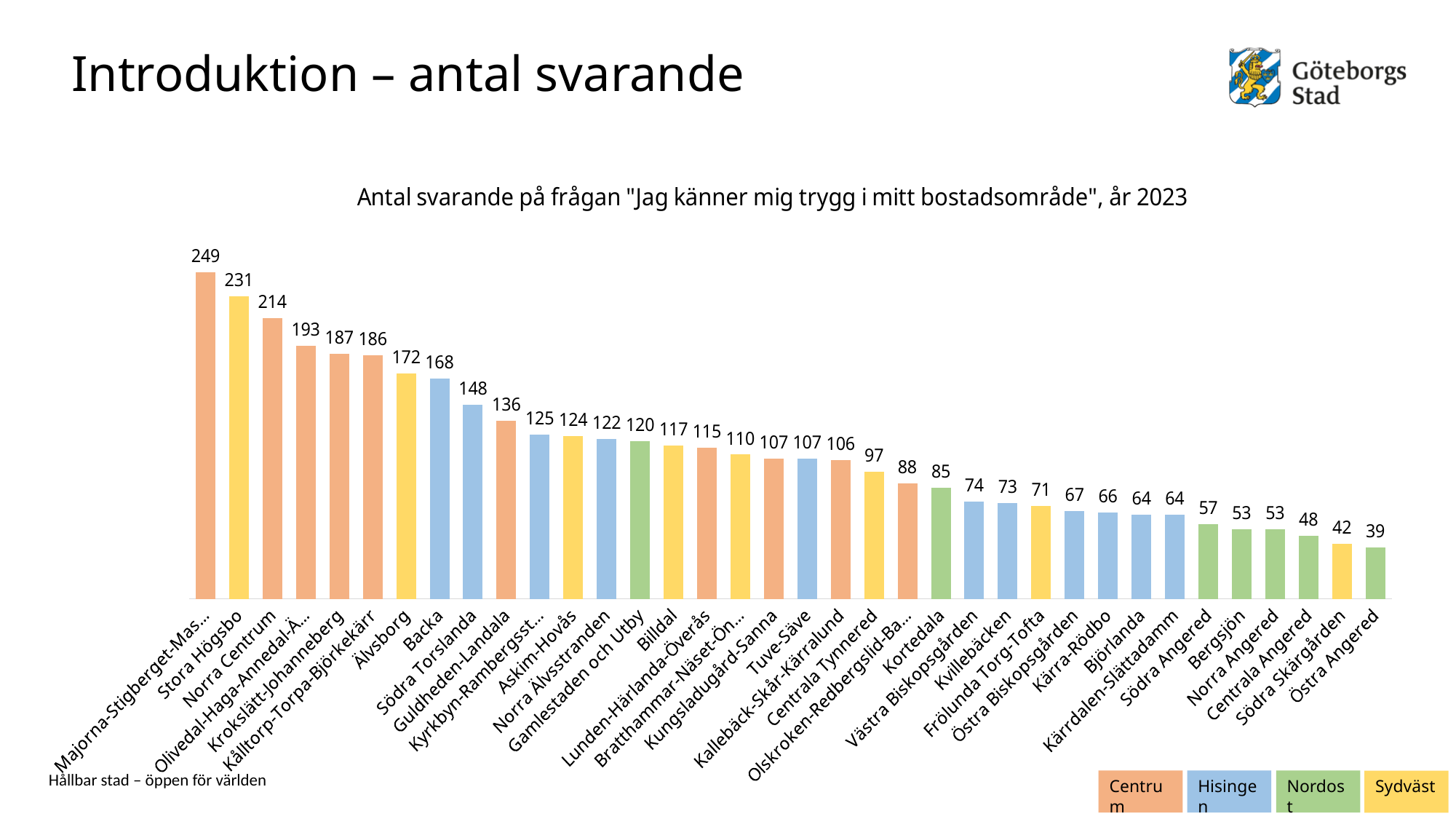
What is the difference between the values for Södra Torslanda and Guldheden-Landala? 12 Which has a larger value, Älvsborg or Billdal? Älvsborg Which area has the lowest number of respondents? Östra Angered Which area has the highest number of respondents? Majorna-Stigberget-Mas... Do the values rise or fall from left to right along the x axis? Fall How many respondents are shown for Backa? 168 What type of chart is shown on the slide? Bar chart How many areas (bars) are shown in the chart? 36 What is the difference between the values for Stora Högsbo and Norra Centrum? 17 What is the value for Frölunda Torg-Tofta? 71 How many entries does the legend list? 4 What is the value for Kortedala? 85